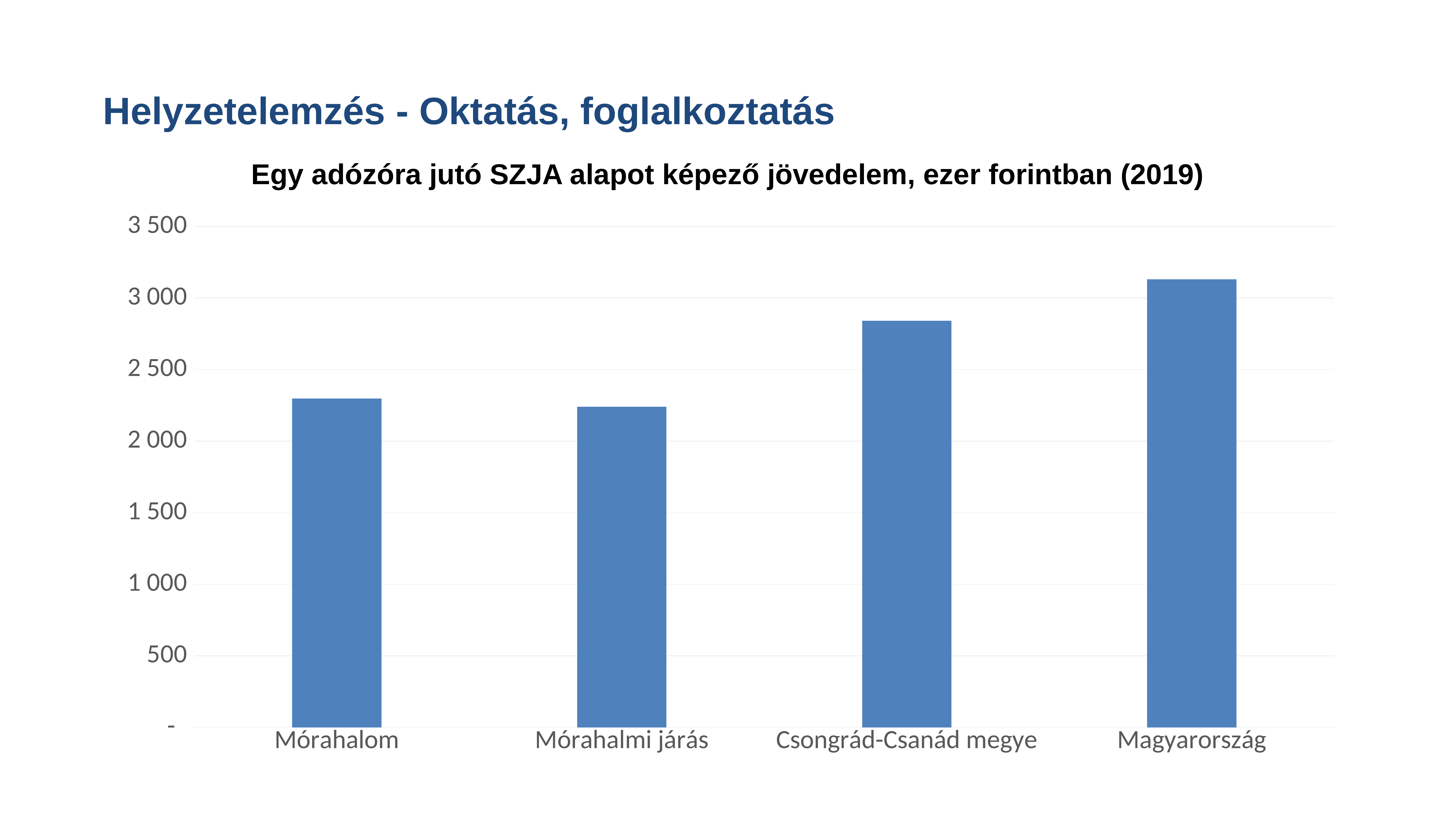
Which is larger, the value for Magyarország or the value for Mórahalom? Magyarország Is the value for Magyarország greater or less than 3 000? greater Is the value for Mórahalmi járás greater or less than 2 500? less Is the value for Mórahalom greater or less than 2 000? greater Which category has the highest value in the chart? Magyarország Which is larger, the value for Csongrád-Csanád megye or the value for Mórahalmi járás? Csongrád-Csanád megye What kind of chart is shown on the slide? bar chart How many categories are shown on the x axis of the chart? 4 What colour are the bars in the chart? blue What is the title of the chart? Egy adózóra jutó SZJA alapot képező jövedelem, ezer forintban (2019)